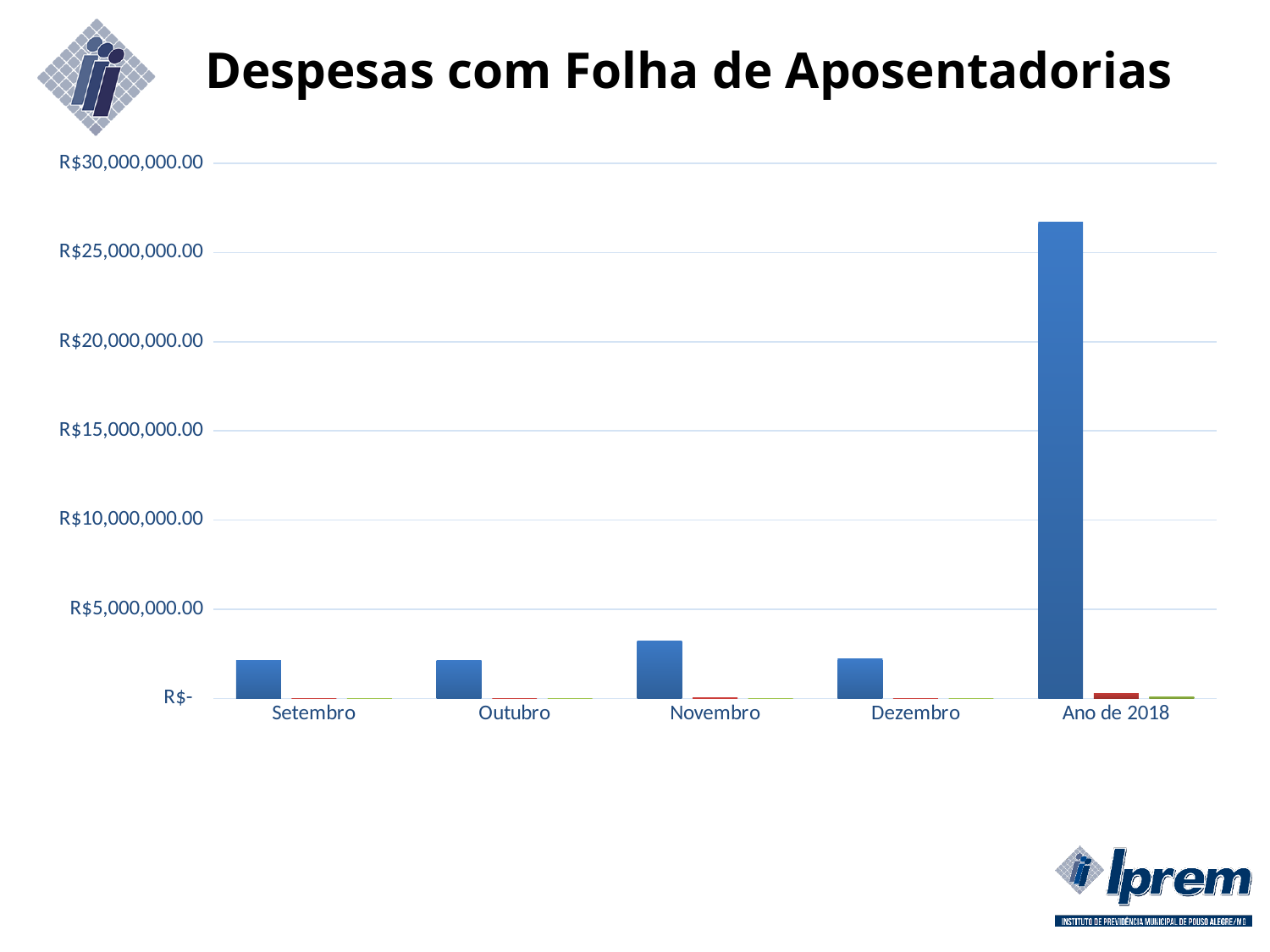
Is the value of the blue bar for Ano de 2018 greater or less than R$25,000,000.00? greater Is the value of the blue bar for Setembro greater or less than R$5,000,000.00? less What kind of chart is shown on the slide? bar chart Is the value of the blue bar for Ano de 2018 greater or less than R$30,000,000.00? less How many categories are shown on the x axis of the chart? 5 Among the four months (Setembro, Outubro, Novembro, Dezembro), which has the tallest blue bar? Novembro What colour is the tallest bar in the chart? blue Which has a taller blue bar, Ano de 2018 or Dezembro? Ano de 2018 Which has a taller blue bar, Novembro or Setembro? Novembro What is the title of the chart? Despesas com Folha de Aposentadorias Which category has the tallest bar in the chart? Ano de 2018